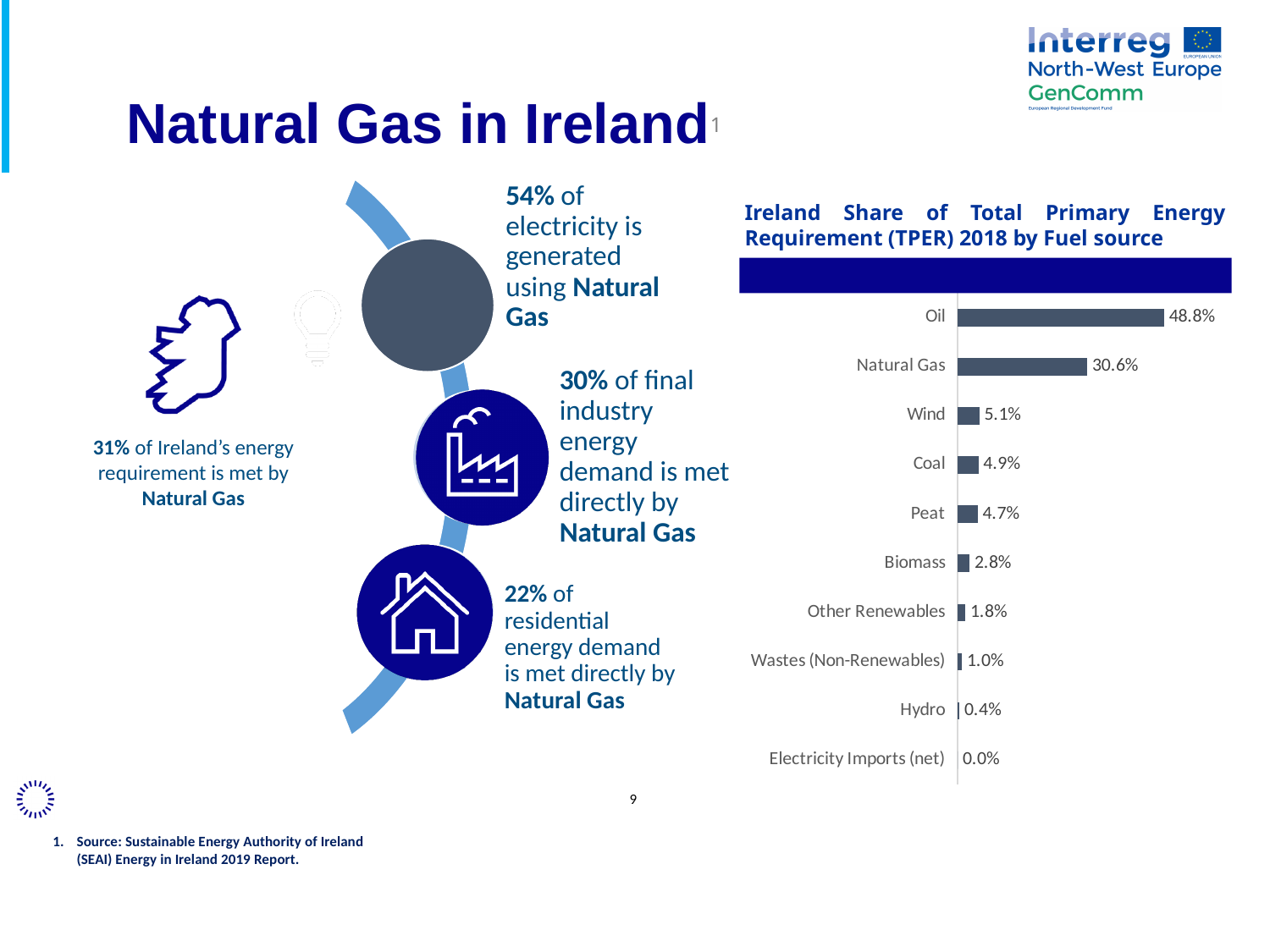
What is the difference between the shares for Oil and Natural Gas? 18.2% Which has a larger share, Biomass or Other Renewables? Biomass What is the title of the chart? Ireland Share of Total Primary Energy Requirement (TPER) 2018 by Fuel source How many fuel source categories are shown in the chart? 10 What type of chart is shown on the slide? Bar chart What is the share for Natural Gas in the chart? 30.6% What is the difference between the shares for Wind and Coal? 0.2% What is the share for Oil in the chart? 48.8% What is the share for Hydro in the chart? 0.4% Which fuel source has the lowest share in the chart? Electricity Imports (net) What is the share for Peat in the chart? 4.7% Which fuel source has the highest share in the chart? Oil